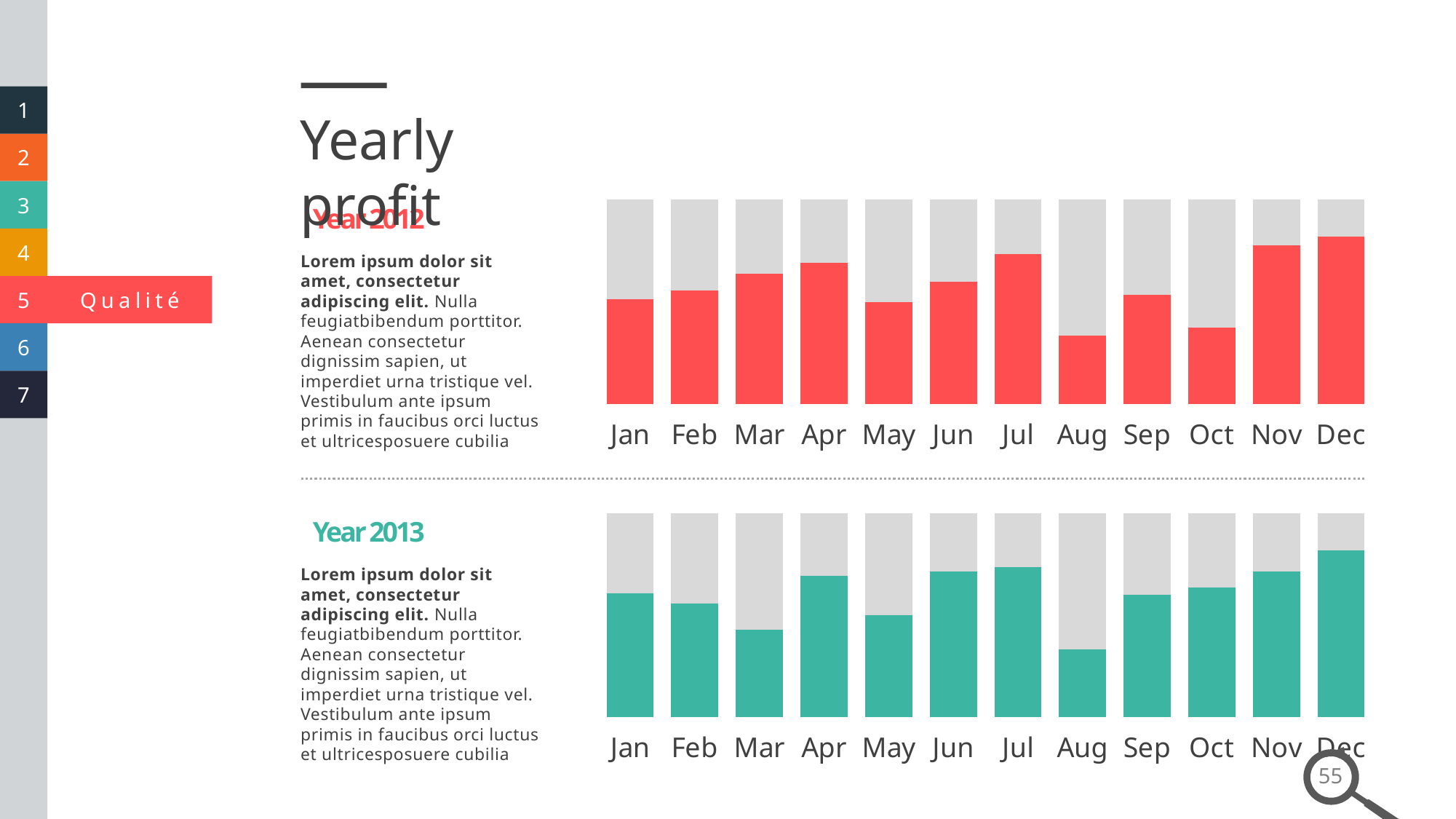
In the Year 2013 chart, which is larger, Mar or Apr? Apr In the Year 2012 chart, which month has the lowest bar? Aug In the Year 2013 chart, which month has the lowest bar? Aug In the Year 2012 chart, which month has the highest bar? Dec What colour are the bars in the Year 2013 chart? teal In the Year 2013 chart, which month has the highest bar? Dec How many months are shown on the Year 2012 chart? 12 How many months are shown on the Year 2013 chart? 12 In the Year 2012 chart, which is larger, Jul or Aug? Jul What kind of chart is the Year 2013 chart? bar chart What kind of chart is the Year 2012 chart? bar chart